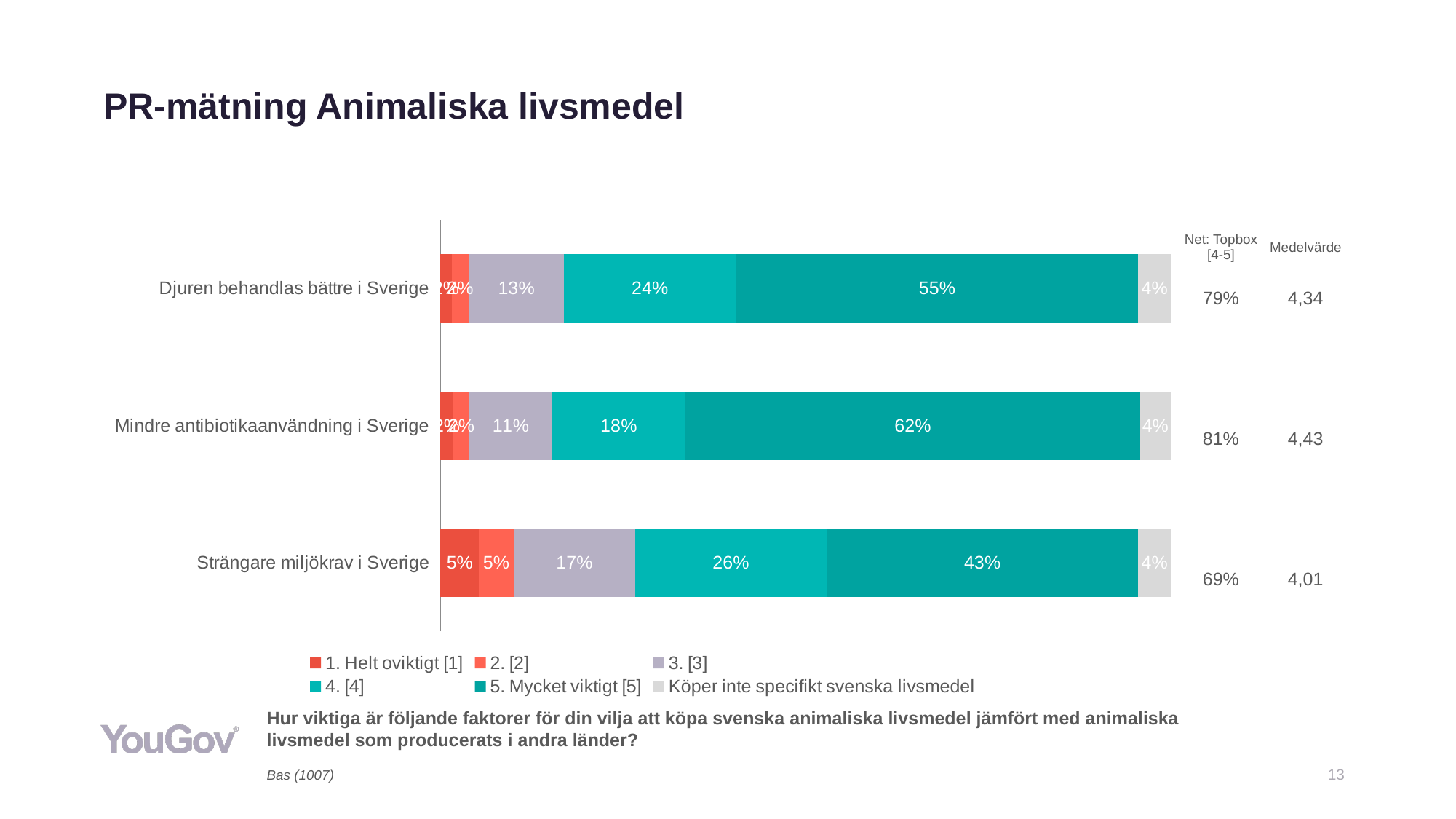
Which category has the highest "5. Mycket viktigt [5]" share? Mindre antibiotikaanvändning i Sverige What percentage of respondents rated "Strängare miljökrav i Sverige" as "1. Helt oviktigt [1]"? 5% Which category has the lowest Net: Topbox [4-5] value? Strängare miljökrav i Sverige Which is larger: the "4. [4]" value for "Strängare miljökrav i Sverige" or for "Mindre antibiotikaanvändning i Sverige"? Strängare miljökrav i Sverige How many series does the legend list? 6 How many categories are shown in the chart? 3 What is the "4. [4]" value for "Djuren behandlas bättre i Sverige"? 24% What percentage of respondents rated "Mindre antibiotikaanvändning i Sverige" as "5. Mycket viktigt [5]"? 62% What is the difference between the "5. Mycket viktigt [5]" values for "Mindre antibiotikaanvändning i Sverige" and "Strängare miljökrav i Sverige"? 19 percentage points What is the Medelvärde (mean value) for "Djuren behandlas bättre i Sverige"? 4,34 What is the "3. [3]" value for "Strängare miljökrav i Sverige"? 17% What kind of chart is shown on the slide? Stacked bar chart